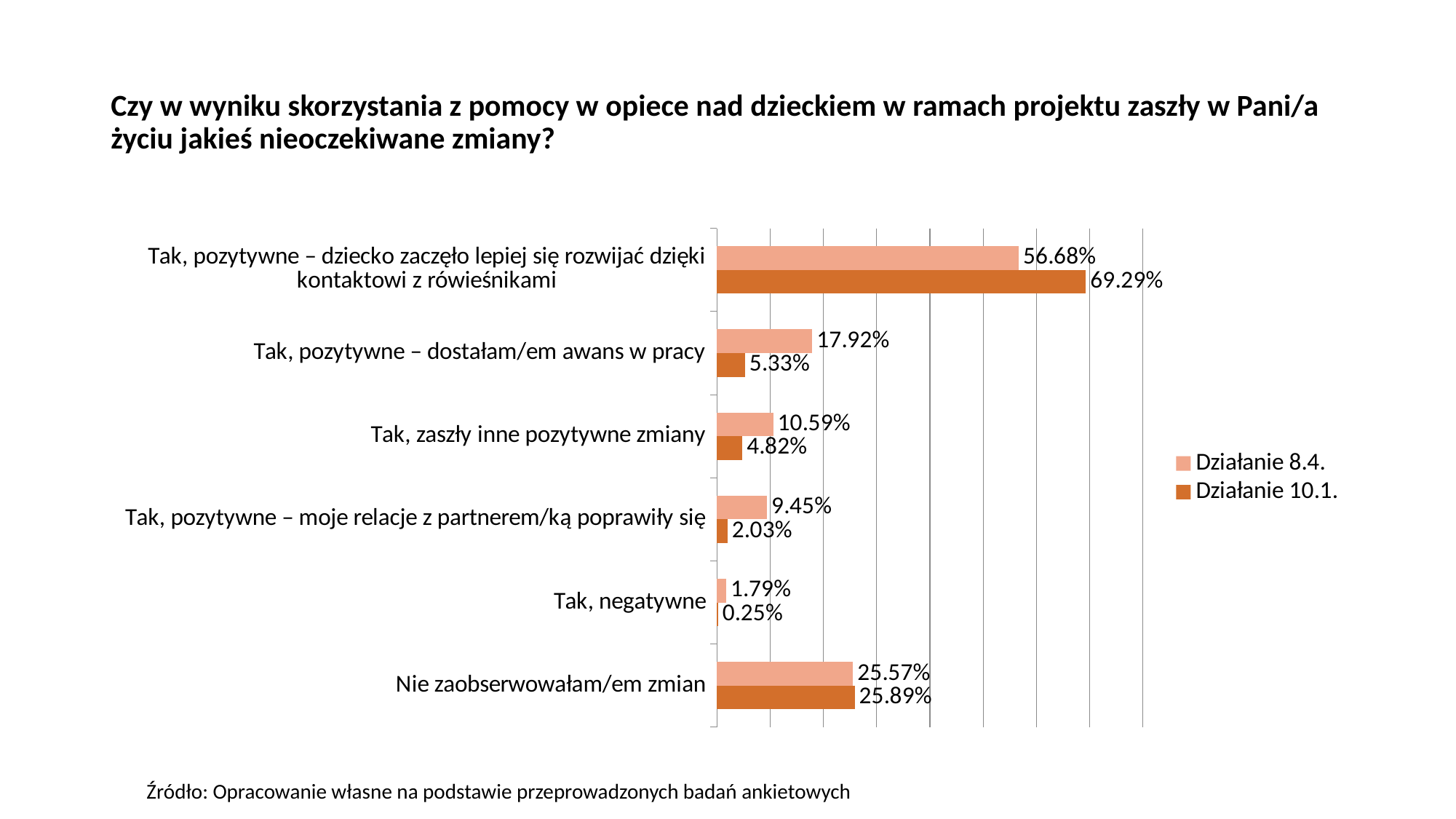
What is the value for "Tak, negatywne" in the Działanie 10.1. series? 0.25% What is the value for "Nie zaobserwowałam/em zmian" in the Działanie 10.1. series? 25.89% What kind of chart is shown on the slide? Bar chart What is the difference between the Działanie 8.4. and Działanie 10.1. values for "Tak, pozytywne – dostałam/em awans w pracy"? 12.59% Which series is shown in the darker orange colour? Działanie 10.1. Which category has the lowest value in the Działanie 8.4. series? Tak, negatywne How many categories are shown on the chart? 6 For "Tak, zaszły inne pozytywne zmiany", which series has the larger value, Działanie 8.4. or Działanie 10.1.? Działanie 8.4. What is the value for "Tak, pozytywne – dostałam/em awans w pracy" in the Działanie 8.4. series? 17.92% How many series does the legend list? 2 What is the difference between the Działanie 10.1. and Działanie 8.4. values for "Tak, pozytywne – dziecko zaczęło lepiej się rozwijać dzięki kontaktowi z rówieśnikami"? 12.61% Which category has the highest value in the Działanie 10.1. series? Tak, pozytywne – dziecko zaczęło lepiej się rozwijać dzięki kontaktowi z rówieśnikami